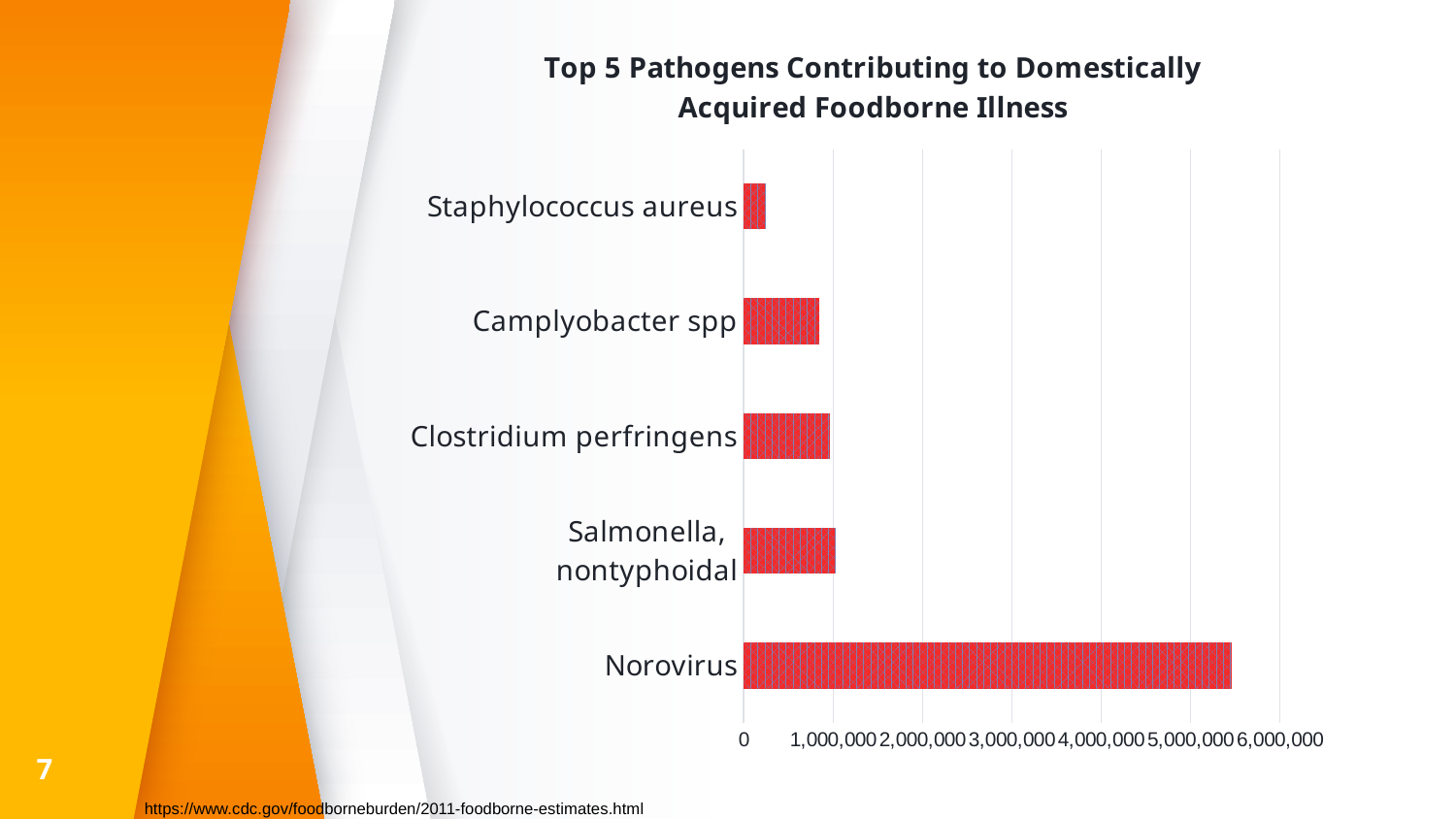
Is the value for Camplyobacter spp greater or less than 1,000,000? less What type of chart is shown on the slide? Bar chart Which is larger, the value for Norovirus or the value for Salmonella, nontyphoidal? Norovirus How many pathogens are plotted in the chart? 5 Which is larger, the value for Staphylococcus aureus or the value for Camplyobacter spp? Camplyobacter spp What is the highest value shown on the horizontal axis of the chart? 6,000,000 Which pathogen has the highest value in the chart? Norovirus Is the value for Staphylococcus aureus greater or less than 1,000,000? less What is the title of the chart? Top 5 Pathogens Contributing to Domestically Acquired Foodborne Illness Is the value for Norovirus greater or less than 5,000,000? greater Which pathogen has the lowest value in the chart? Staphylococcus aureus